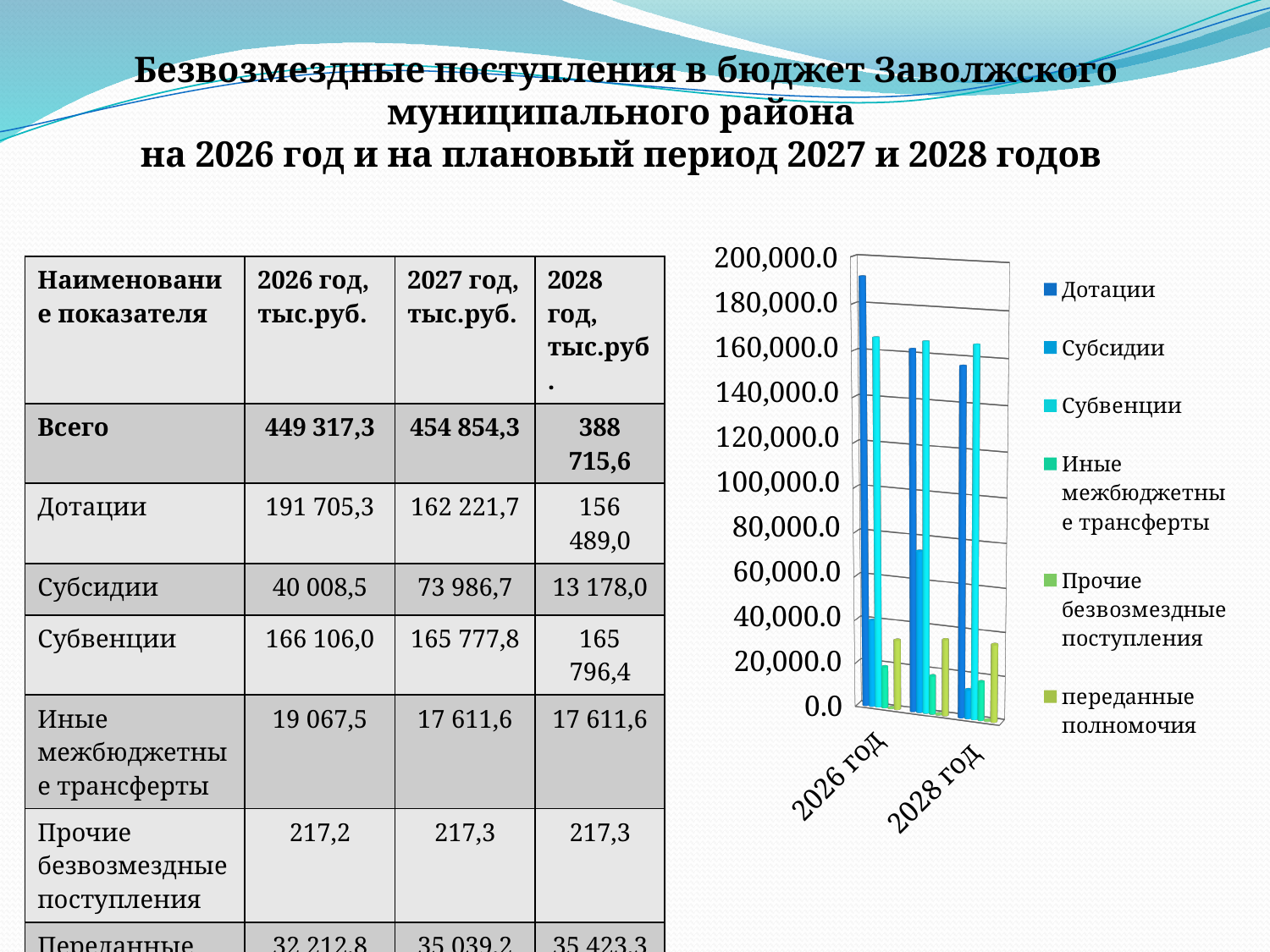
What kind of chart is shown on the slide? bar chart What is the highest value shown on the chart's vertical axis? 200,000.0 How many series does the chart legend list? 6 In the 2028 год group, which bar is taller: Дотации or Субвенции? Субвенции Which series has the tallest bar in the 2026 год group? Дотации How many year groups of bars are plotted in the chart? 3 Is the value for Субсидии in 2028 год greater or less than 20,000.0? less According to the table on the slide, what is the value for Субсидии in 2027 год, тыс.руб.? 73 986,7 Which series has the shortest bar in the 2026 год group? Прочие безвозмездные поступления Do the Дотации bars rise or fall from 2026 год to 2028 год? fall Is the value for Субсидии in 2027 год greater or less than 60,000.0? greater Is the value for Дотации in 2026 год greater or less than 180,000.0? greater